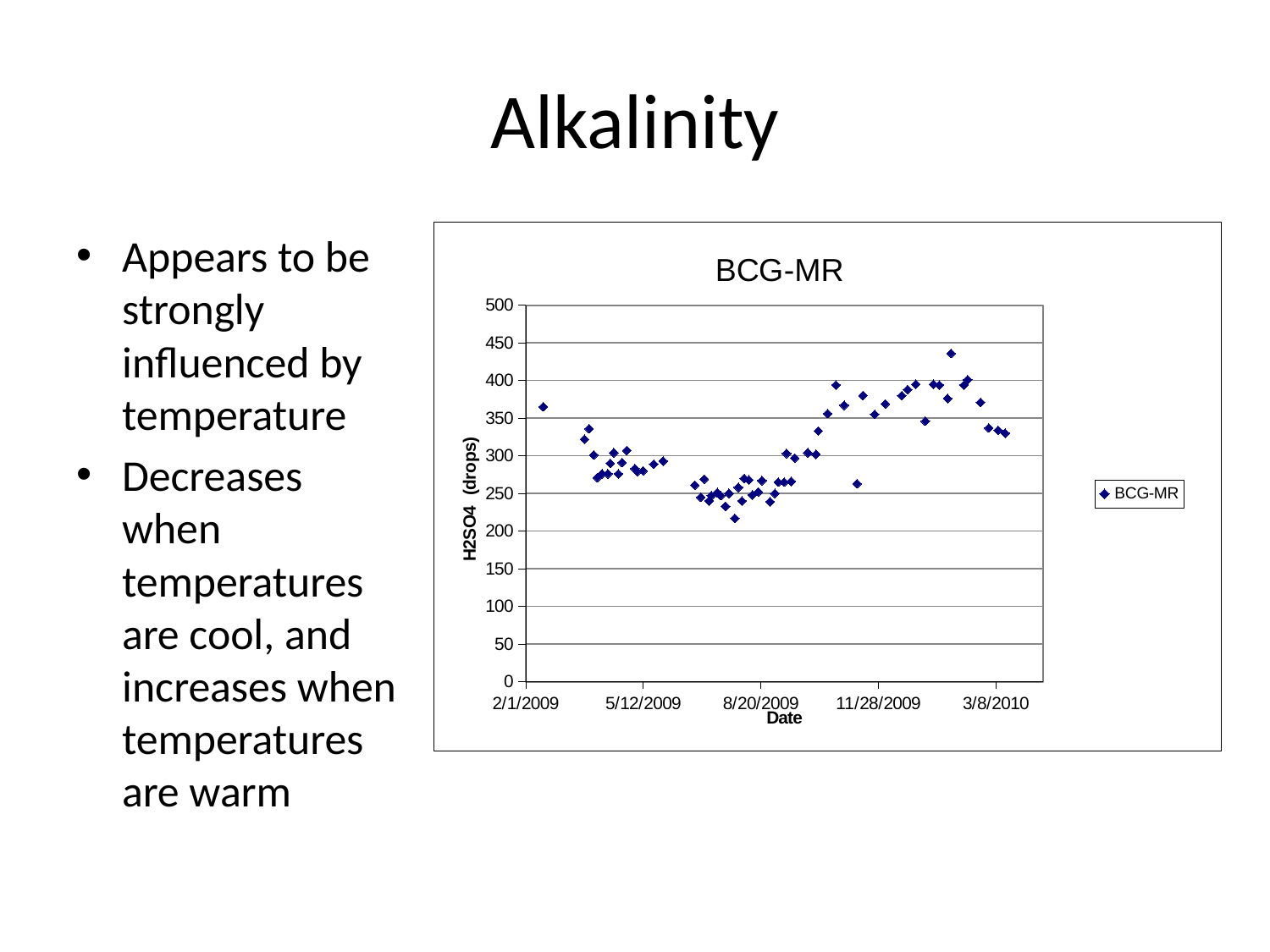
What is the title of the chart? BCG-MR Do the values generally rise or fall between 8/20/2009 and 11/28/2009? rise Is the earliest plotted point (near 2/1/2009) greater or less than 350? greater Is the lowest value plotted on the chart greater or less than 250? less What is the label of the y axis of the chart? H2SO4 (drops) What kind of chart is shown on the slide? scatter chart Do the values generally rise or fall between 2/1/2009 and 8/20/2009? fall Are the values plotted around 8/20/2009 greater or less than 300? less How many series does the chart legend list? 1